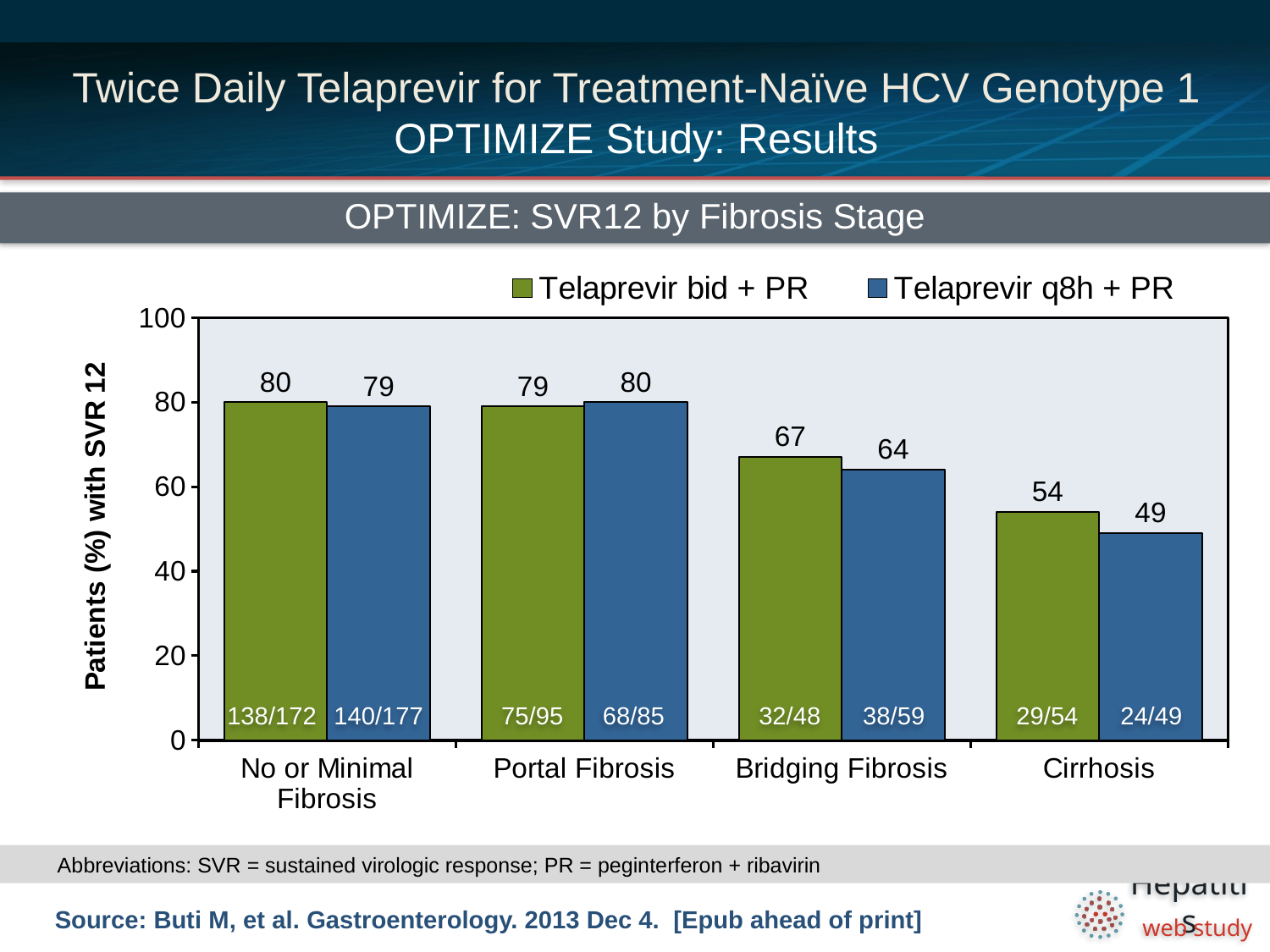
What is the difference between the Telaprevir bid + PR and Telaprevir q8h + PR SVR12 rates in patients with Cirrhosis? 5 Which fibrosis stage has the highest SVR12 rate for Telaprevir bid + PR? No or Minimal Fibrosis How many fibrosis stage categories are shown on the x axis? 4 What is the SVR12 rate for Telaprevir bid + PR in patients with Cirrhosis? 54 What is the SVR12 rate for Telaprevir q8h + PR in patients with Bridging Fibrosis? 64 In patients with Bridging Fibrosis, which regimen has the higher SVR12 rate, Telaprevir bid + PR or Telaprevir q8h + PR? Telaprevir bid + PR What is the title of the chart? OPTIMIZE: SVR12 by Fibrosis Stage What kind of chart is shown on the slide? Bar chart Do the SVR12 rates for Telaprevir bid + PR rise or fall as fibrosis stage progresses from No or Minimal Fibrosis to Cirrhosis? Fall How many series does the legend list? 2 What is the SVR12 rate for Telaprevir q8h + PR in patients with No or Minimal Fibrosis? 79 Which fibrosis stage has the lowest SVR12 rate for Telaprevir q8h + PR? Cirrhosis